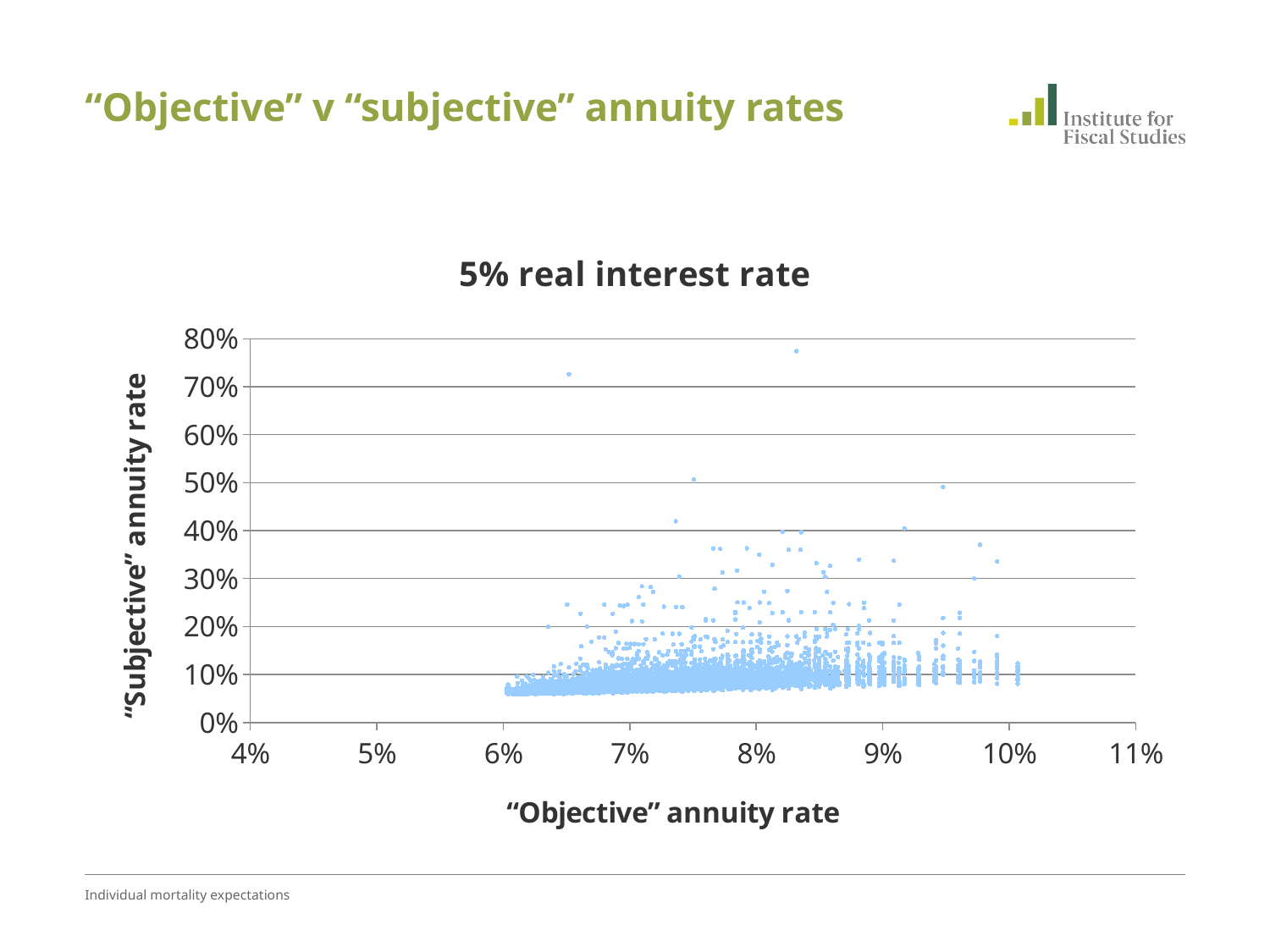
Do the "subjective" annuity rates of the bulk of the points tend to rise or fall as the "objective" annuity rate increases along the x axis? rise Is the lowest "subjective" annuity rate plotted greater or less than 10%? less What is the title of the chart? 5% real interest rate Is the highest "subjective" annuity rate plotted greater or less than 80%? less What kind of chart is shown on the slide? Scatter plot Is the highest "objective" annuity rate plotted greater or less than 11%? less What is the label of the vertical axis of the chart? "Subjective" annuity rate